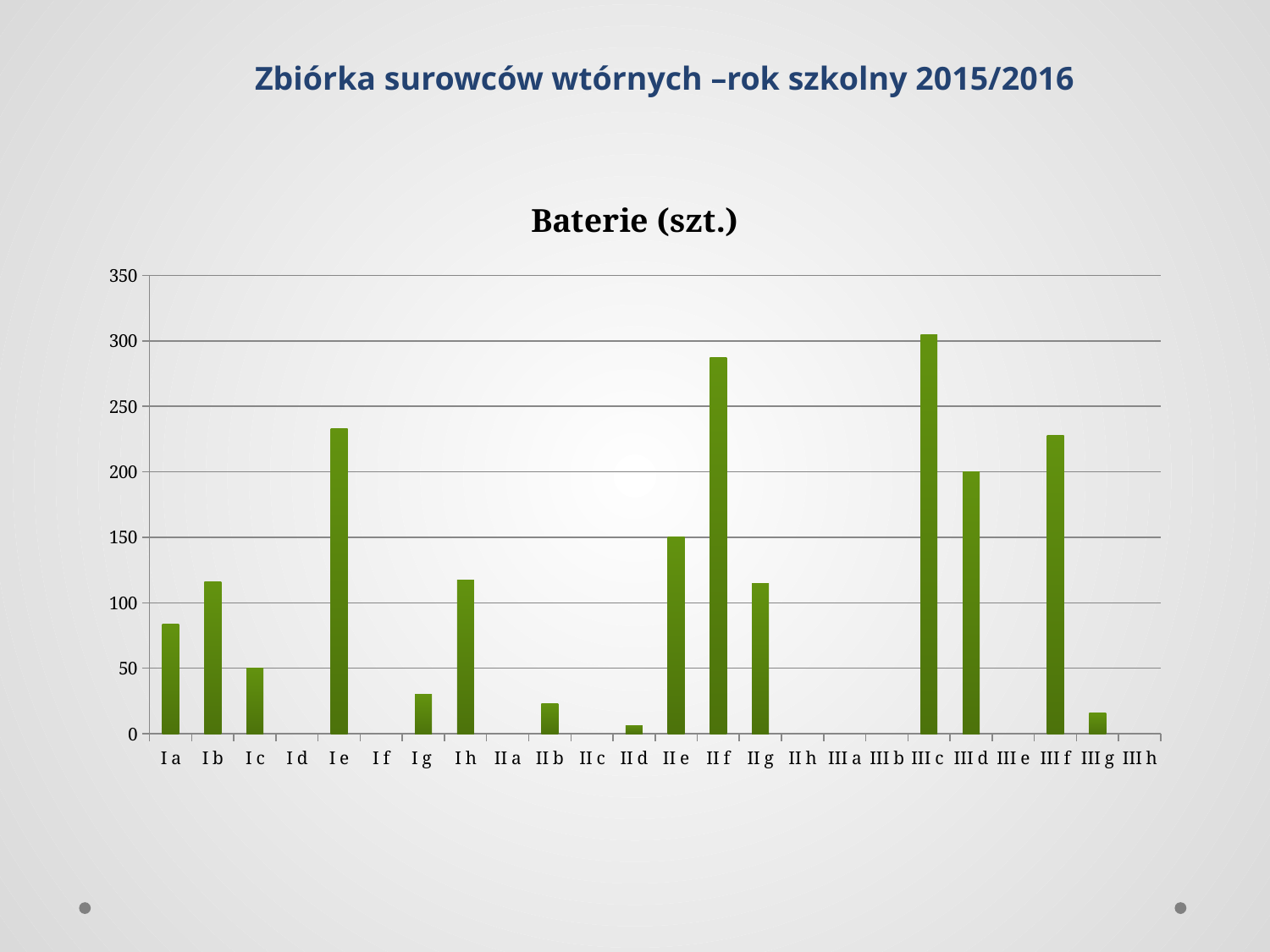
What is the value for III d? 200 What is the value for II e? 150 Which is larger, the value for III f or the value for II g? III f What kind of chart is shown on the slide? bar chart How many classes (categories) are shown on the x axis? 24 Is the value for I a greater or less than 100? less Is the value for II f greater or less than 250? greater Is the value for I e greater or less than 200? greater Which class has the highest number of batteries collected? III c What is the value for I c? 50 What is the title of the chart? Baterie (szt.) Which is larger, the value for I e or the value for II e? I e